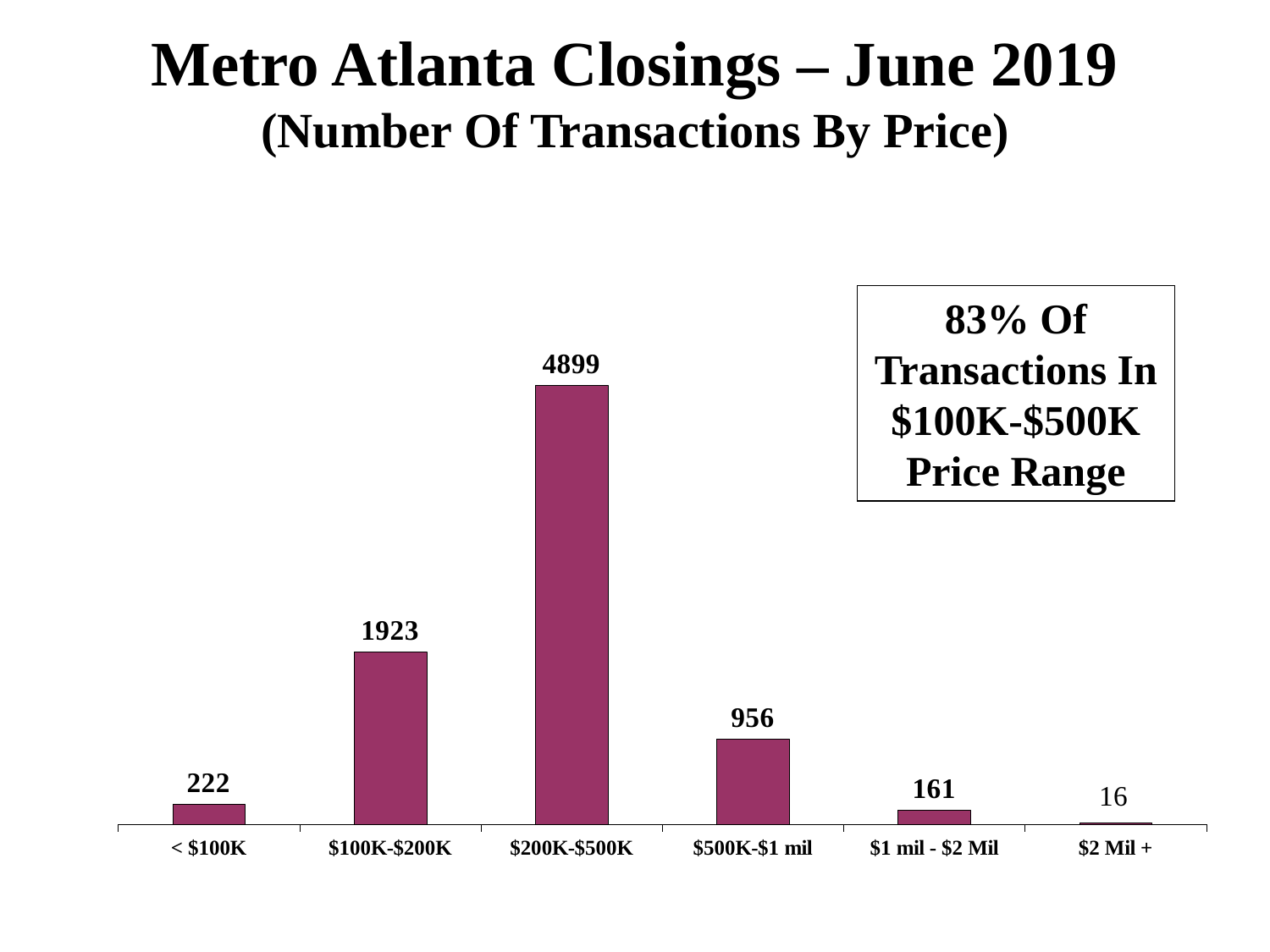
What type of chart is shown on the slide? Bar chart What is the combined number of transactions in the $100K-$200K and $200K-$500K ranges? 6822 Which price range has the lowest number of transactions? $2 Mil + What is the number of transactions for the $100K-$200K category? 1923 How many transactions were in the $200K-$500K price range? 4899 Which has more transactions: < $100K or $1 mil - $2 Mil? < $100K How many price range categories are shown on the chart? 6 According to the text box on the slide, what percentage of transactions were in the $100K-$500K price range? 83% Which price range has the highest number of transactions? $200K-$500K How many transactions were in the $500K-$1 mil range? 956 What value is shown for the $2 Mil + category? 16 What is the difference between the number of transactions in the $200K-$500K range and the $100K-$200K range? 2976